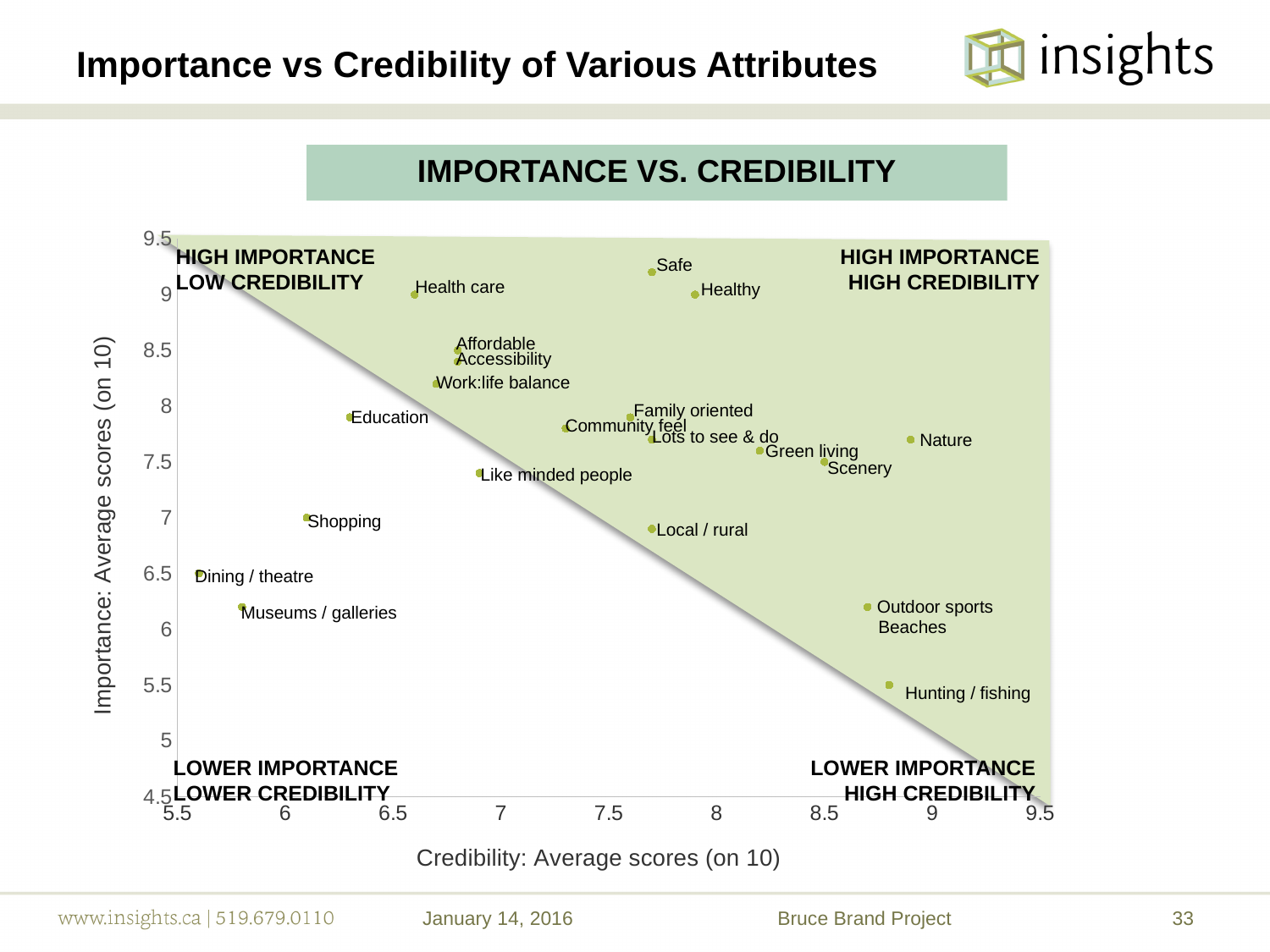
Which attribute has the lowest credibility score on the chart? Dining / theatre Is the importance score for Safe greater or less than 9? greater Which attribute has the highest importance score on the chart? Safe Which attribute has the lowest importance score on the chart? Hunting / fishing What is the label of the x axis of the chart? Credibility: Average scores (on 10) Which has the higher importance score, Safe or Healthy? Safe What is the title of the chart? IMPORTANCE VS. CREDIBILITY What kind of chart is shown on the slide? Scatter chart Is the credibility score for Nature greater or less than 8.5? greater Which has the higher credibility score, Nature or Education? Nature Is the credibility score for Education greater or less than 6.5? less